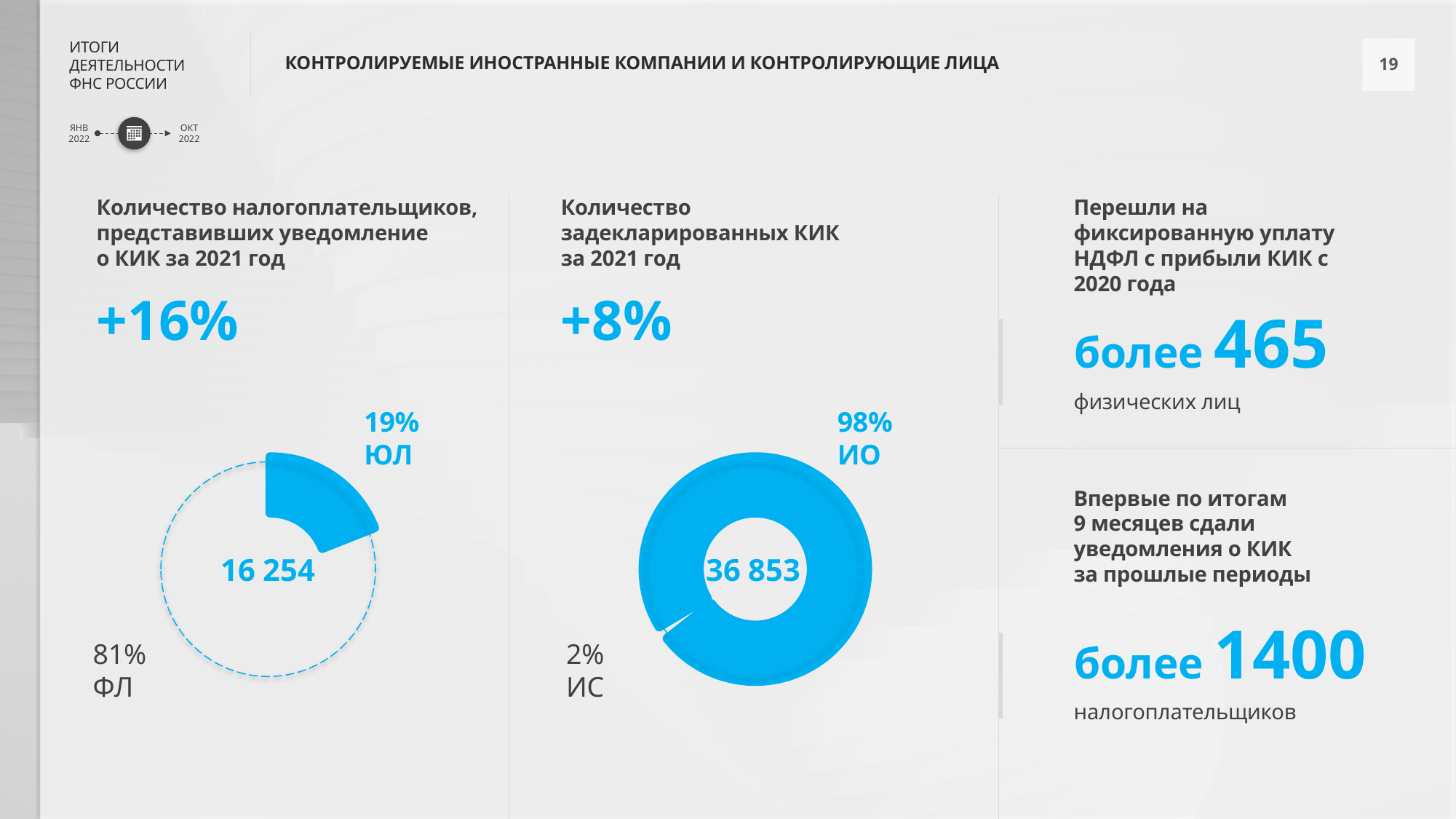
What percentage growth is printed above the left chart (Количество налогоплательщиков, представивших уведомление о КИК за 2021 год)? +16% On the right chart (Количество задекларированных КИК за 2021 год), which category has the smallest share? ИС On the right chart (Количество задекларированных КИК за 2021 год), what share is labelled ИО? 98% On the right chart (Количество задекларированных КИК за 2021 год), what total number is shown in the centre of the donut? 36 853 On the left chart (Количество налогоплательщиков, представивших уведомление о КИК за 2021 год), what is the difference in percentage points between the ФЛ share and the ЮЛ share? 62 percentage points How many categories does the right chart (Количество задекларированных КИК за 2021 год) show? 2 On the left chart (Количество налогоплательщиков, представивших уведомление о КИК за 2021 год), what share is labelled ФЛ? 81% On the left chart (Количество налогоплательщиков, представивших уведомление о КИК за 2021 год), what total number is shown in the centre of the donut? 16 254 On the left chart (Количество налогоплательщиков, представивших уведомление о КИК за 2021 год), which category has the larger share, ЮЛ or ФЛ? ФЛ What kind of chart is used on the left for Количество налогоплательщиков, представивших уведомление о КИК за 2021 год? Donut (pie) chart On the right chart (Количество задекларированных КИК за 2021 год), what share is labelled ИС? 2% On the left chart (Количество налогоплательщиков, представивших уведомление о КИК за 2021 год), what share is labelled ЮЛ? 19%